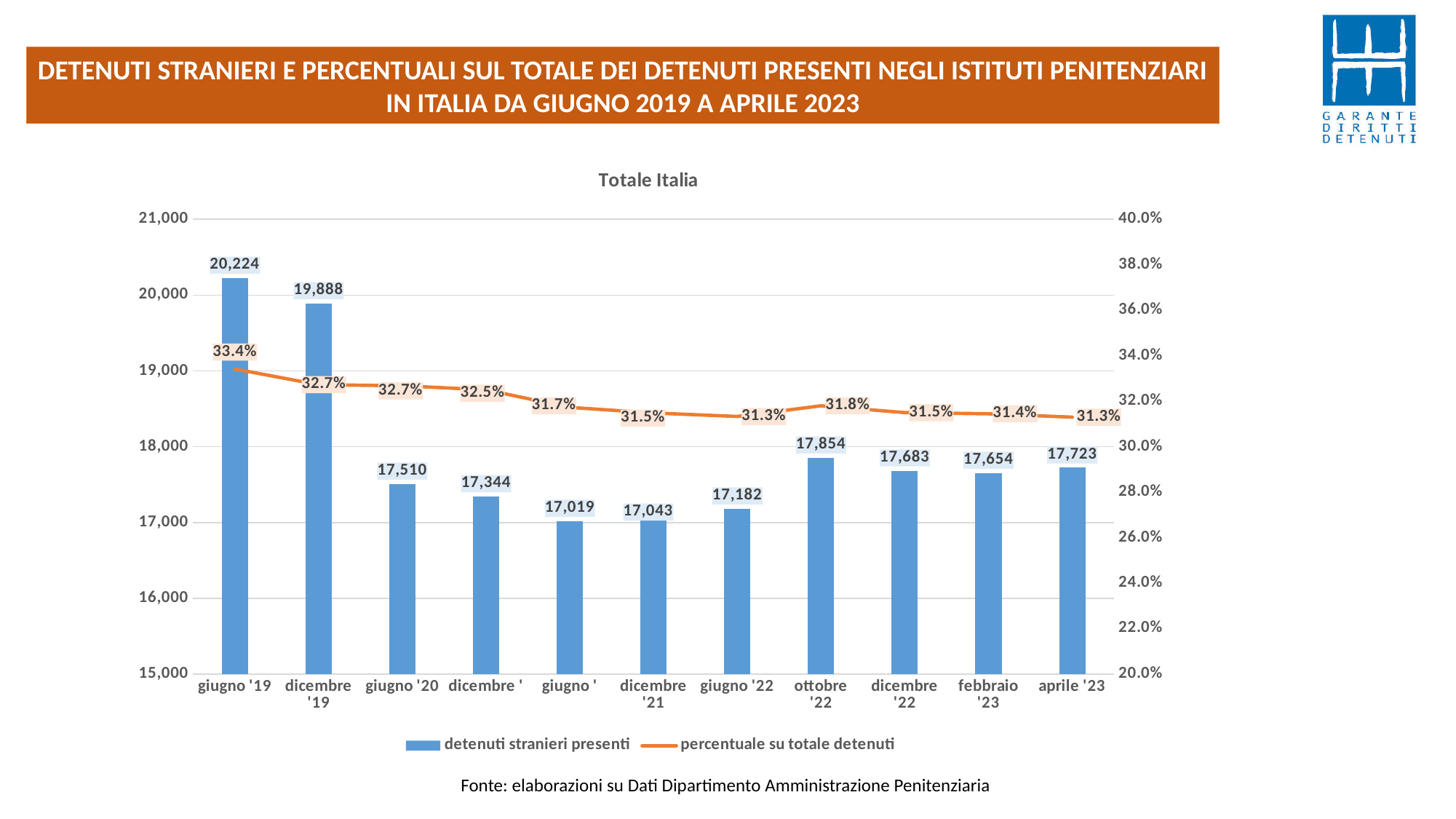
What is the value of detenuti stranieri presenti for giugno '19? 20,224 What is the percentuale su totale detenuti for giugno '19? 33.4% How many periods are shown on the x axis? 11 How many series does the legend list? 2 Which period has the highest number of detenuti stranieri presenti? giugno '19 What is the percentuale su totale detenuti for ottobre '22? 31.8% Which is larger, the number of detenuti stranieri presenti in ottobre '22 or in dicembre '22? ottobre '22 What kind of chart is shown? Combined bar and line chart What is the title of the chart? Totale Italia What is the difference in detenuti stranieri presenti between giugno '19 and dicembre '19? 336 What is the value of detenuti stranieri presenti for aprile '23? 17,723